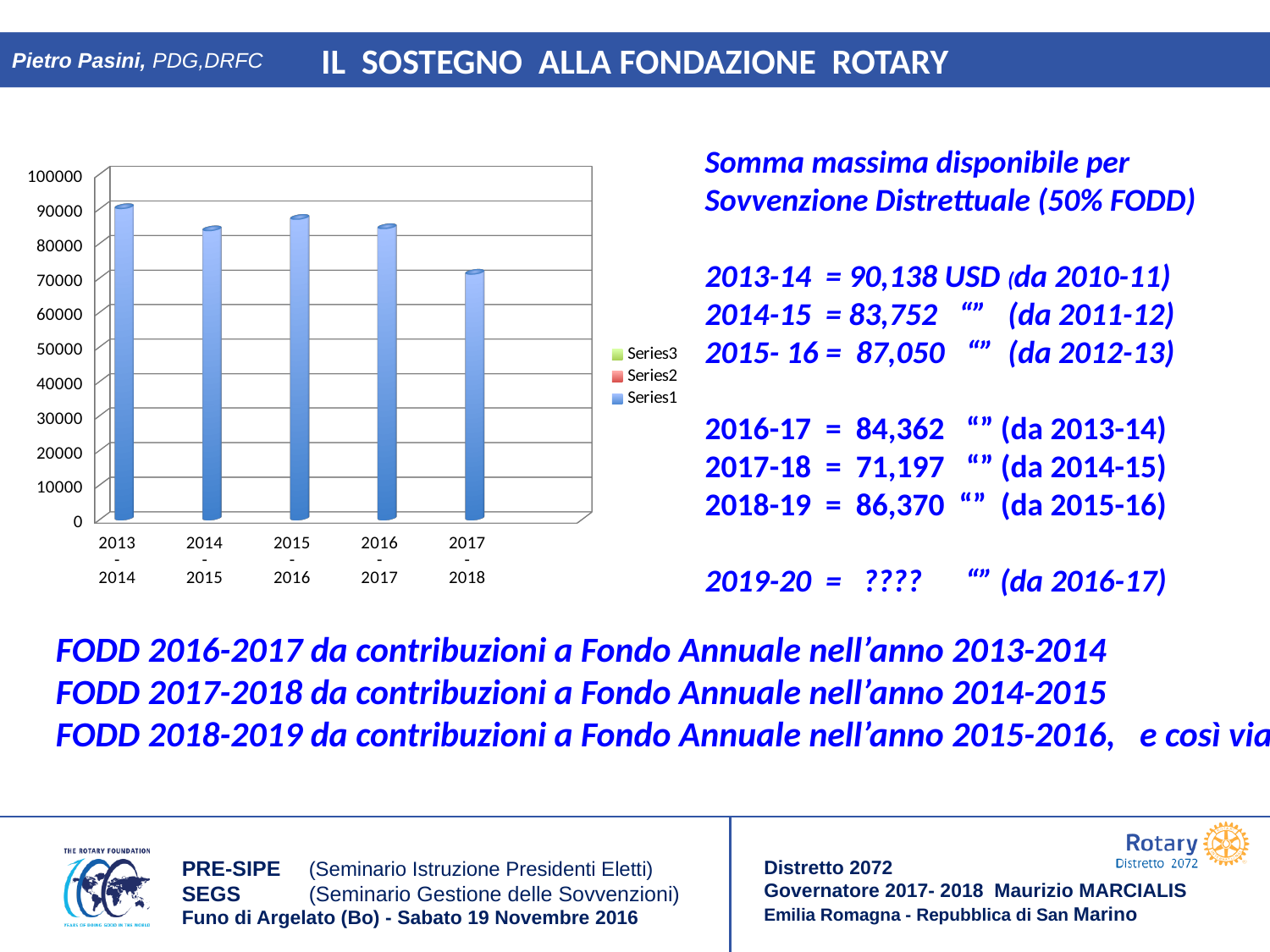
Which category has the tallest bar in the chart? 2013-2014 What kind of chart is shown on the slide? bar chart Which is larger, the bar for 2015-2016 or the bar for 2014-2015? 2015-2016 Is the value for 2014-2015 greater or less than 90000? less Is the value for 2017-2018 greater or less than 70000? greater How many series does the chart legend list? 3 Is the bar for 2017-2018 higher or lower than the bar for 2013-2014? lower Is the value for 2017-2018 greater or less than 80000? less What is the highest value shown on the chart's vertical axis? 100000 How many bars (categories) does the chart show? 5 Which category has the shortest bar in the chart? 2017-2018